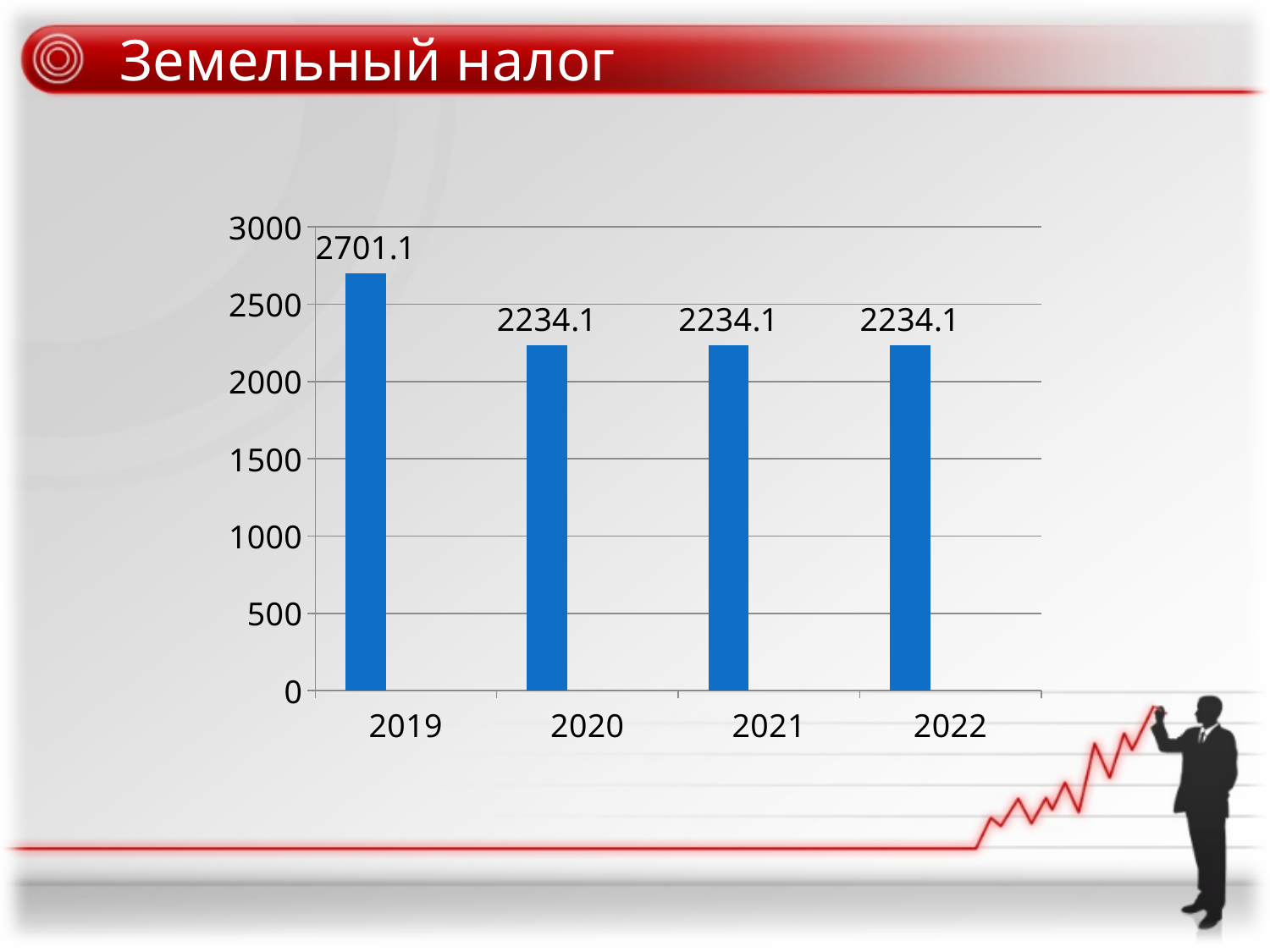
Is the value for 2021 greater or less than 2500? less Which is larger, the value for 2019 or the value for 2021? 2019 What is the value for 2019? 2701.1 Is the value for 2019 greater or less than 2500? greater Which year has the highest value? 2019 What is the difference between the values for 2019 and 2020? 467 Do the values rise or fall from 2019 to 2020? fall What is the value for 2022? 2234.1 What is the value for 2020? 2234.1 What kind of chart is shown on the slide? bar chart What is the title of the slide? Земельный налог How many years are shown on the x axis? 4